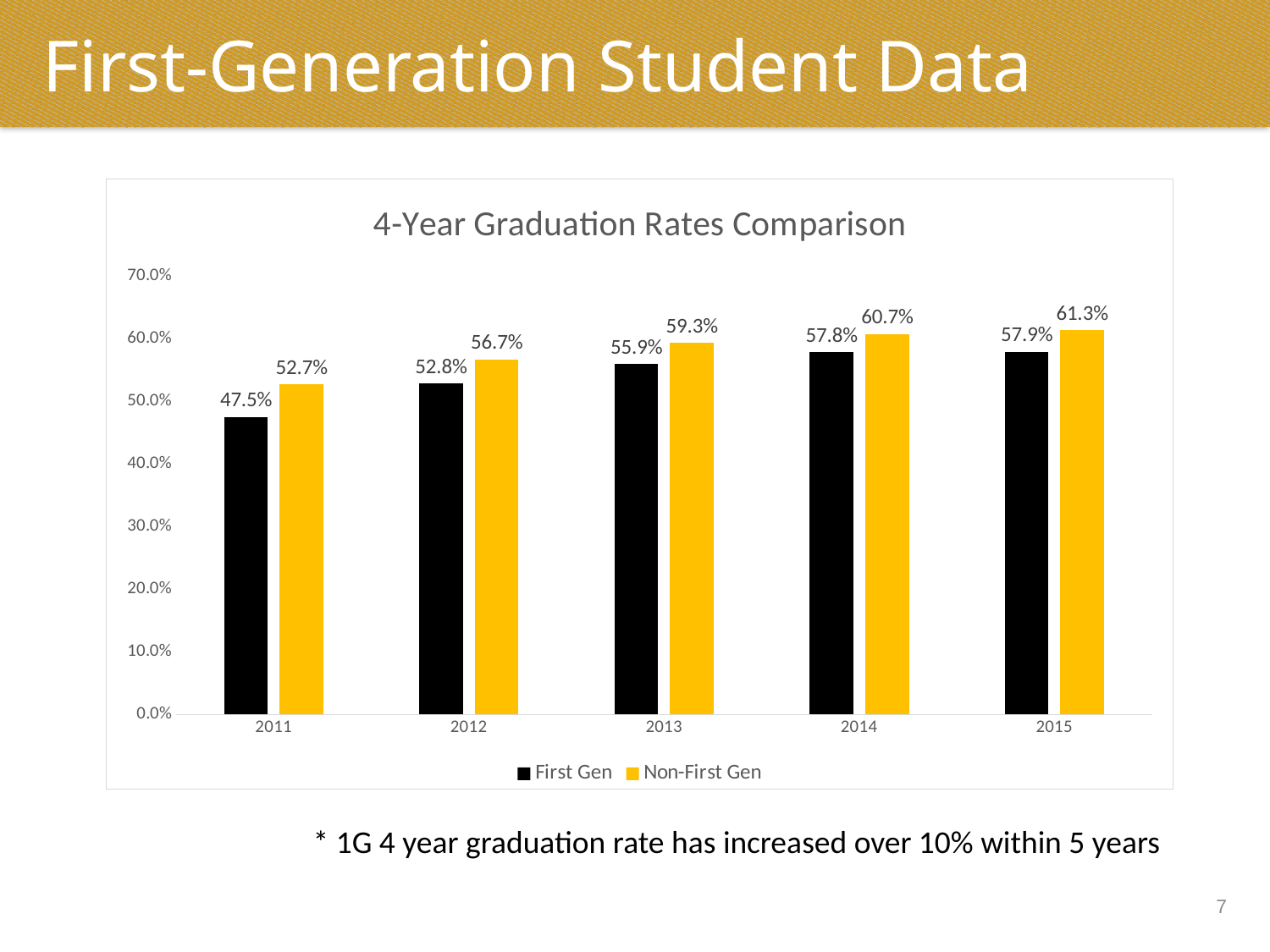
What is the difference between the First Gen rates in 2015 and 2011? 10.4% How many years are shown on the x axis? 5 What is the difference between the Non-First Gen and First Gen rates in 2011? 5.2% Which year has the highest Non-First Gen graduation rate? 2015 How many series does the legend list? 2 What is the Non-First Gen 4-year graduation rate for 2015? 61.3% Which is larger in 2014, the First Gen rate or the Non-First Gen rate? Non-First Gen Is the First Gen value for 2012 greater or less than 50.0%? greater What kind of chart is shown on the slide? Bar chart What is the First Gen value for 2013? 55.9% What is the First Gen 4-year graduation rate for 2011? 47.5% Which year has the lowest First Gen graduation rate? 2011